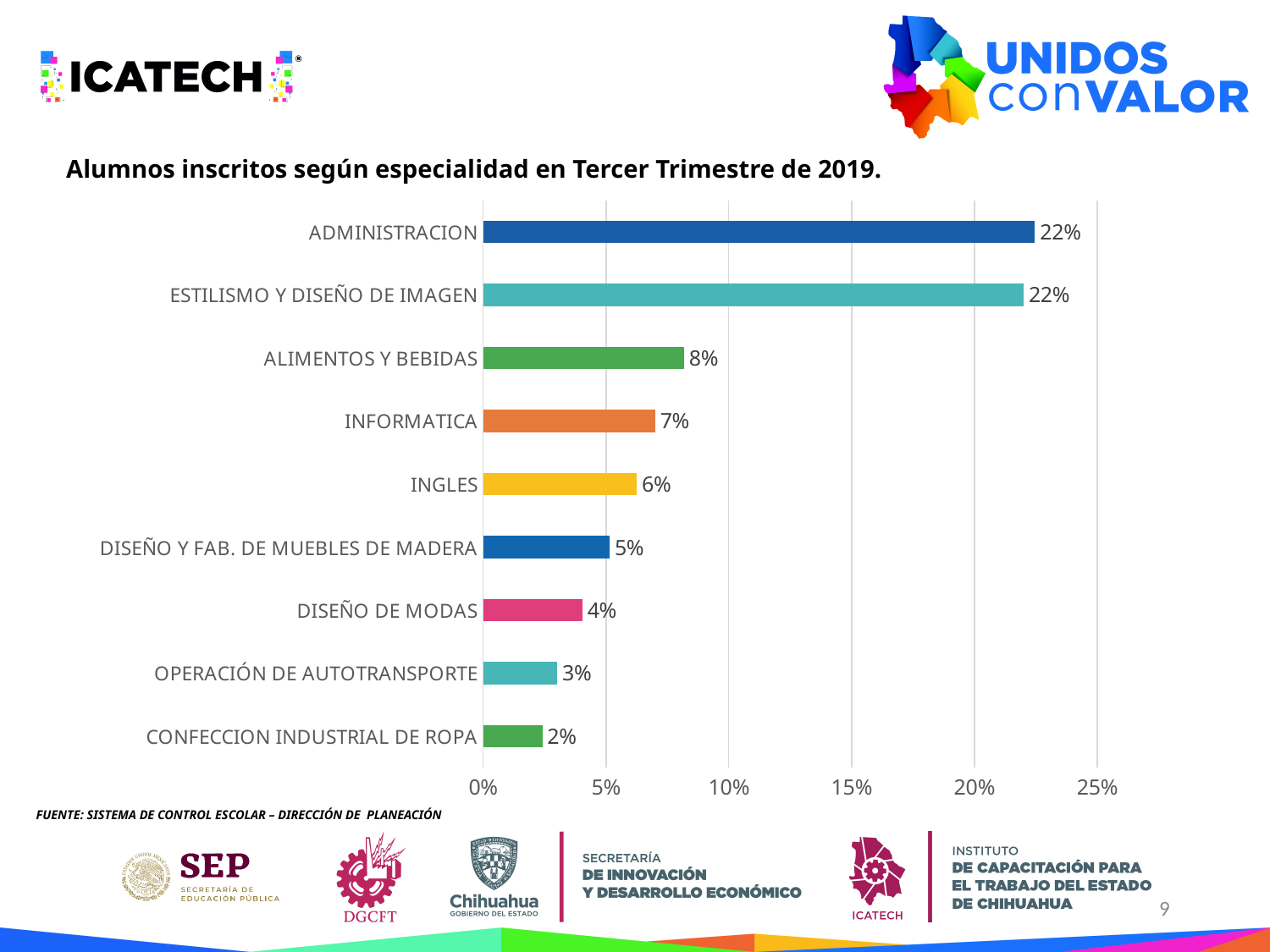
What kind of chart is shown on the slide? bar chart How many specialties are shown in the chart? 9 What is the value for ALIMENTOS Y BEBIDAS? 8% Is the value for ADMINISTRACION greater or less than 20%? greater What is the value for DISEÑO DE MODAS? 4% What is the difference between the values for ADMINISTRACION and CONFECCION INDUSTRIAL DE ROPA? 20% Which is larger, the value for INGLES or the value for DISEÑO Y FAB. DE MUEBLES DE MADERA? INGLES What is the title of the chart? Alumnos inscritos según especialidad en Tercer Trimestre de 2019. What is the difference between the values for ALIMENTOS Y BEBIDAS and INGLES? 2% What is the value for ESTILISMO Y DISEÑO DE IMAGEN? 22% Which specialty has the lowest value? CONFECCION INDUSTRIAL DE ROPA What is the value for INFORMATICA? 7%